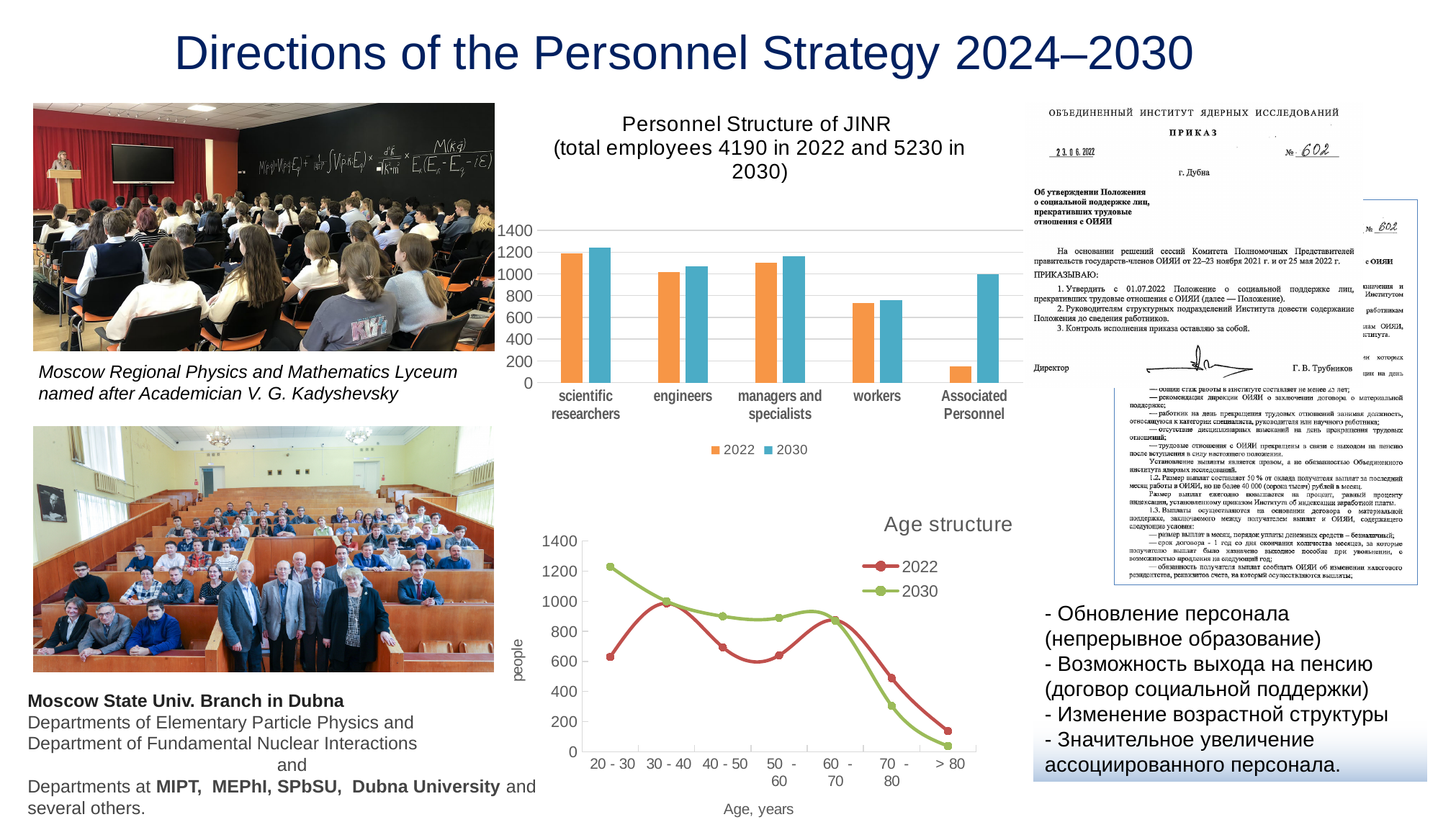
In the 'Personnel Structure of JINR' chart, which is larger for Associated Personnel: the 2022 value or the 2030 value? 2030 How many age groups are plotted on the x axis of the 'Age structure' chart? 7 How many personnel categories are shown on the 'Personnel Structure of JINR' chart? 5 In the 'Personnel Structure of JINR' chart, which category has the lowest value for 2022? Associated Personnel In the 'Personnel Structure of JINR' chart, which category has the highest value for 2030? scientific researchers What kind of chart is the 'Age structure' chart? line chart In the 'Personnel Structure of JINR' chart, is the 2022 value for Associated Personnel greater or less than 400? less How many series does the legend of the 'Personnel Structure of JINR' chart list? 2 In the 'Age structure' chart, which age group has the lowest value for 2022? > 80 What kind of chart is the 'Personnel Structure of JINR' chart? bar chart In the 'Age structure' chart, which age group has the highest value for 2030? 20 - 30 In the 'Personnel Structure of JINR' chart, is the 2030 value for workers greater or less than 800? less